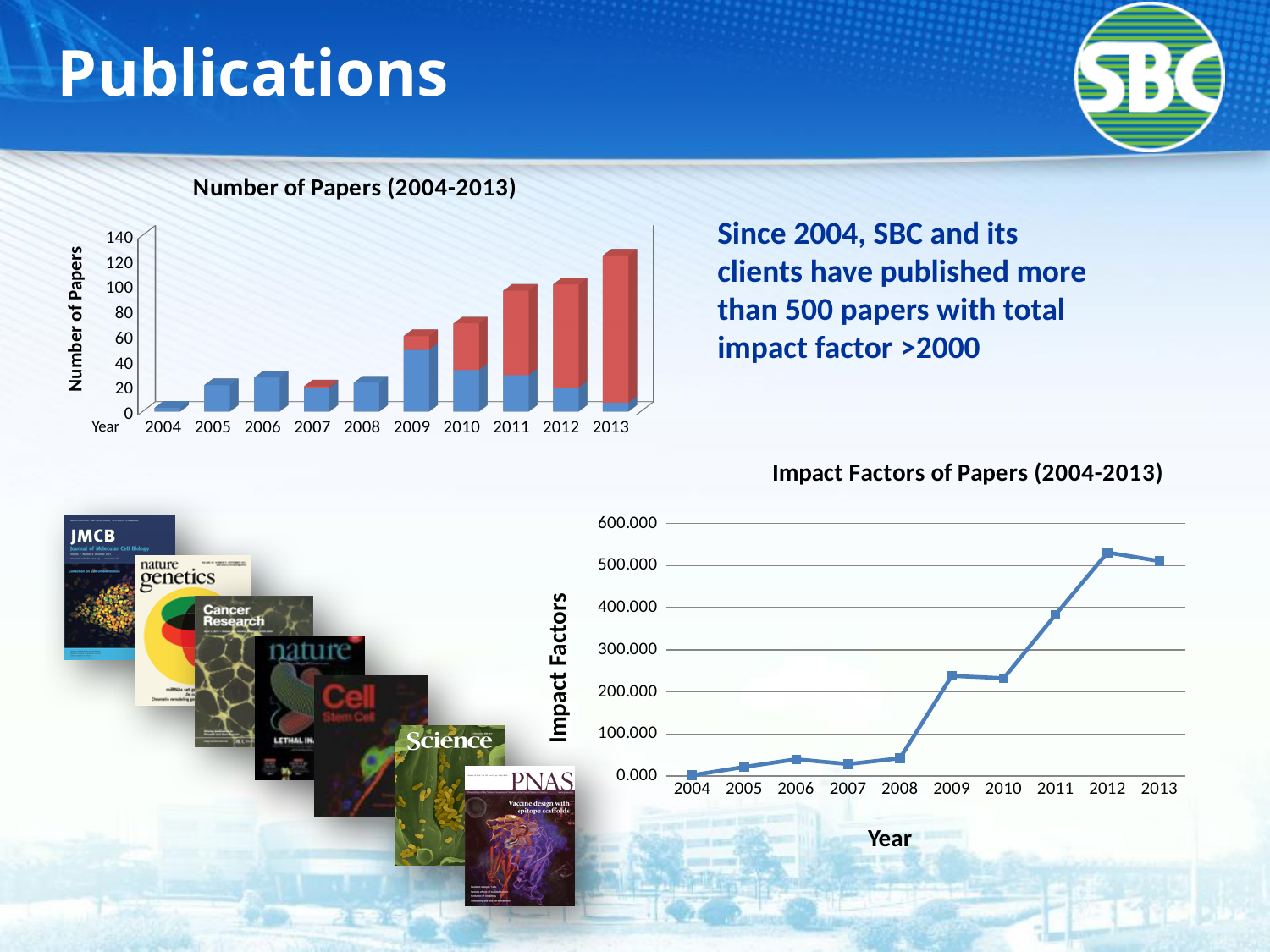
In the "Number of Papers (2004-2013)" chart, which bar is taller, 2010 or 2005? 2010 In the "Number of Papers (2004-2013)" chart, how many years are shown on the x axis? 10 In the "Number of Papers (2004-2013)" chart, is the total bar height for 2006 greater or less than 20? greater What kind of chart is the "Number of Papers (2004-2013)" chart? Bar chart In the "Impact Factors of Papers (2004-2013)" chart, do the values generally rise or fall from 2004 to 2013? rise In the "Impact Factors of Papers (2004-2013)" chart, which year has the lowest value? 2004 In the "Number of Papers (2004-2013)" chart, is the total bar height for 2013 greater or less than 100? greater In the "Number of Papers (2004-2013)" chart, which year has the shortest bar? 2004 What kind of chart is the "Impact Factors of Papers (2004-2013)" chart? Line chart In the "Impact Factors of Papers (2004-2013)" chart, is the value for 2011 greater or less than 400.000? less In the "Impact Factors of Papers (2004-2013)" chart, which year has the highest value? 2012 In the "Number of Papers (2004-2013)" chart, which year has the tallest bar? 2013